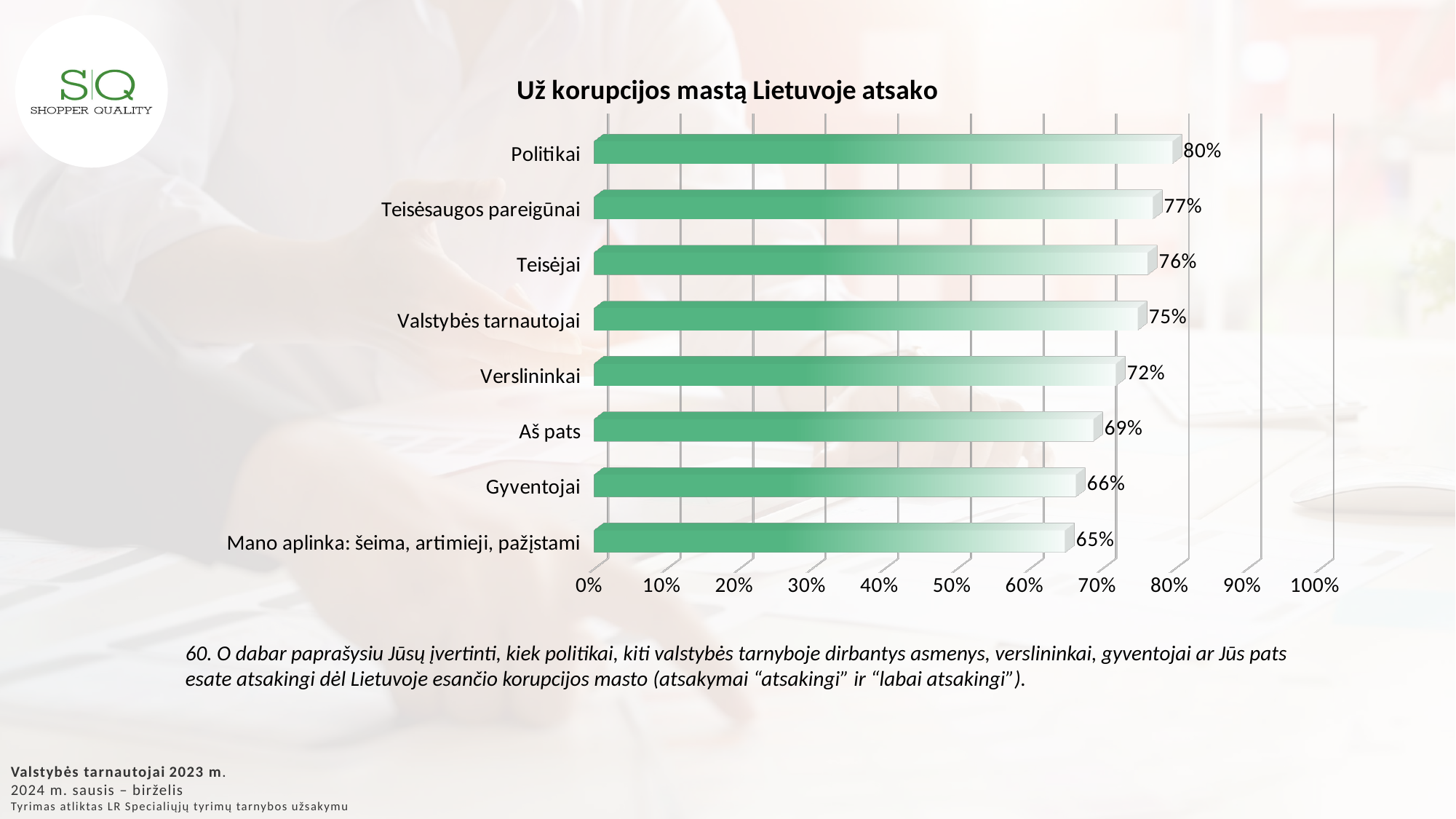
What is the value for Politikai? 80% What is the title of the chart? Už korupcijos mastą Lietuvoje atsako How many categories are shown in the chart? 8 What is the value for Verslininkai? 72% Is the value for Valstybės tarnautojai greater or less than 70%? greater What kind of chart is shown on the slide? bar chart Which category has the lowest value? Mano aplinka: šeima, artimieji, pažįstami What is the value for Teisėsaugos pareigūnai? 77% What is the difference between the values for Politikai and Gyventojai? 14% Which category has the highest value? Politikai Which is larger, the value for Teisėjai or the value for Aš pats? Teisėjai What is the value for Mano aplinka: šeima, artimieji, pažįstami? 65%